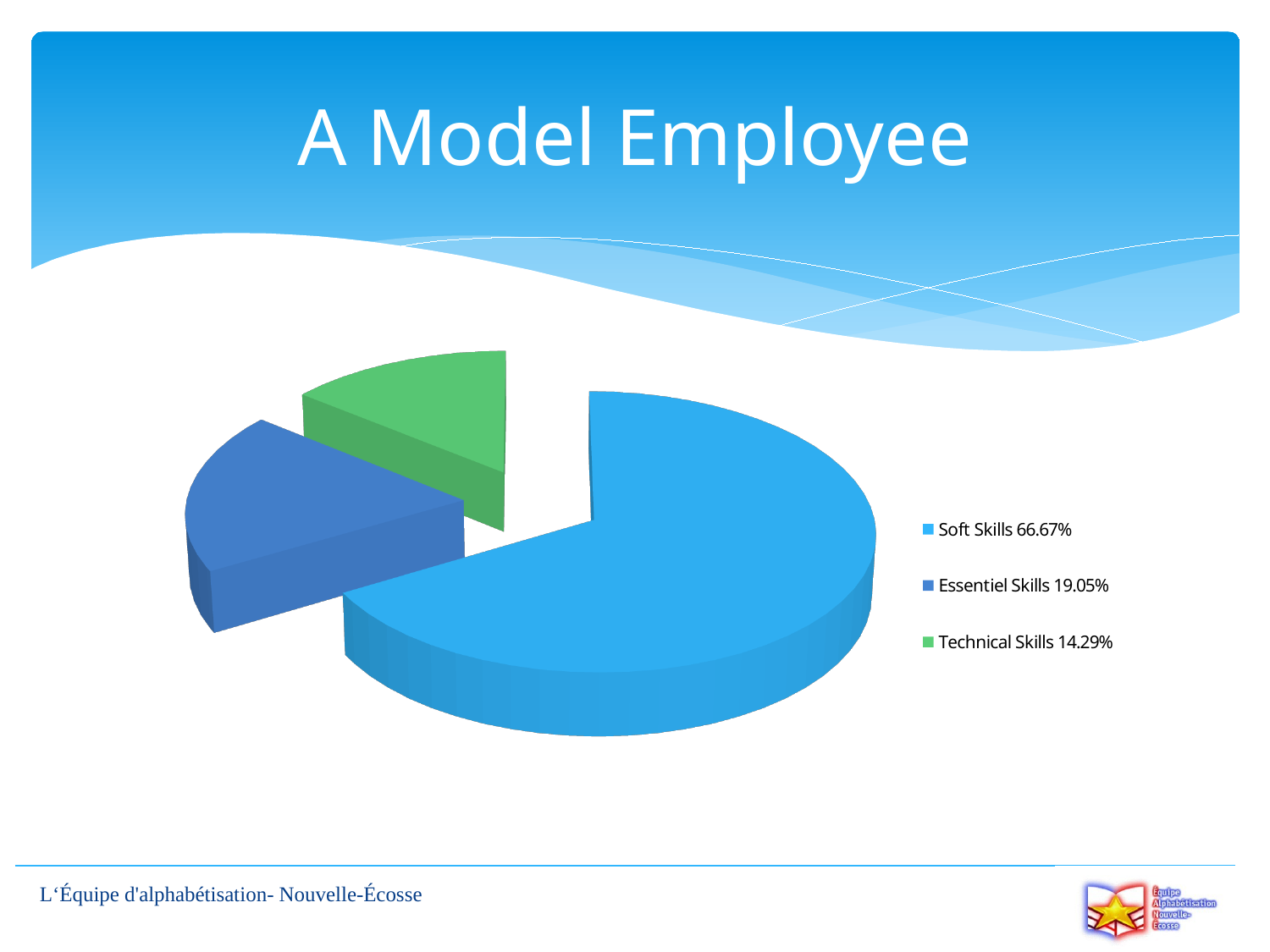
What share of the pie does Soft Skills represent? 66.67% How many slices does the pie chart have? 3 What is the difference between the Soft Skills share and the Essentiel Skills share? 47.62% What kind of chart is shown on the slide? Pie chart Which category has the smallest slice of the pie? Technical Skills Which category has the largest slice of the pie? Soft Skills What colour is the Technical Skills slice? Green What share of the pie does Essentiel Skills represent? 19.05% What is the difference between the Essentiel Skills share and the Technical Skills share? 4.76% Which is larger, the Essentiel Skills slice or the Technical Skills slice? Essentiel Skills What share of the pie does Technical Skills represent? 14.29% Is the share for Soft Skills greater or less than 50%? greater